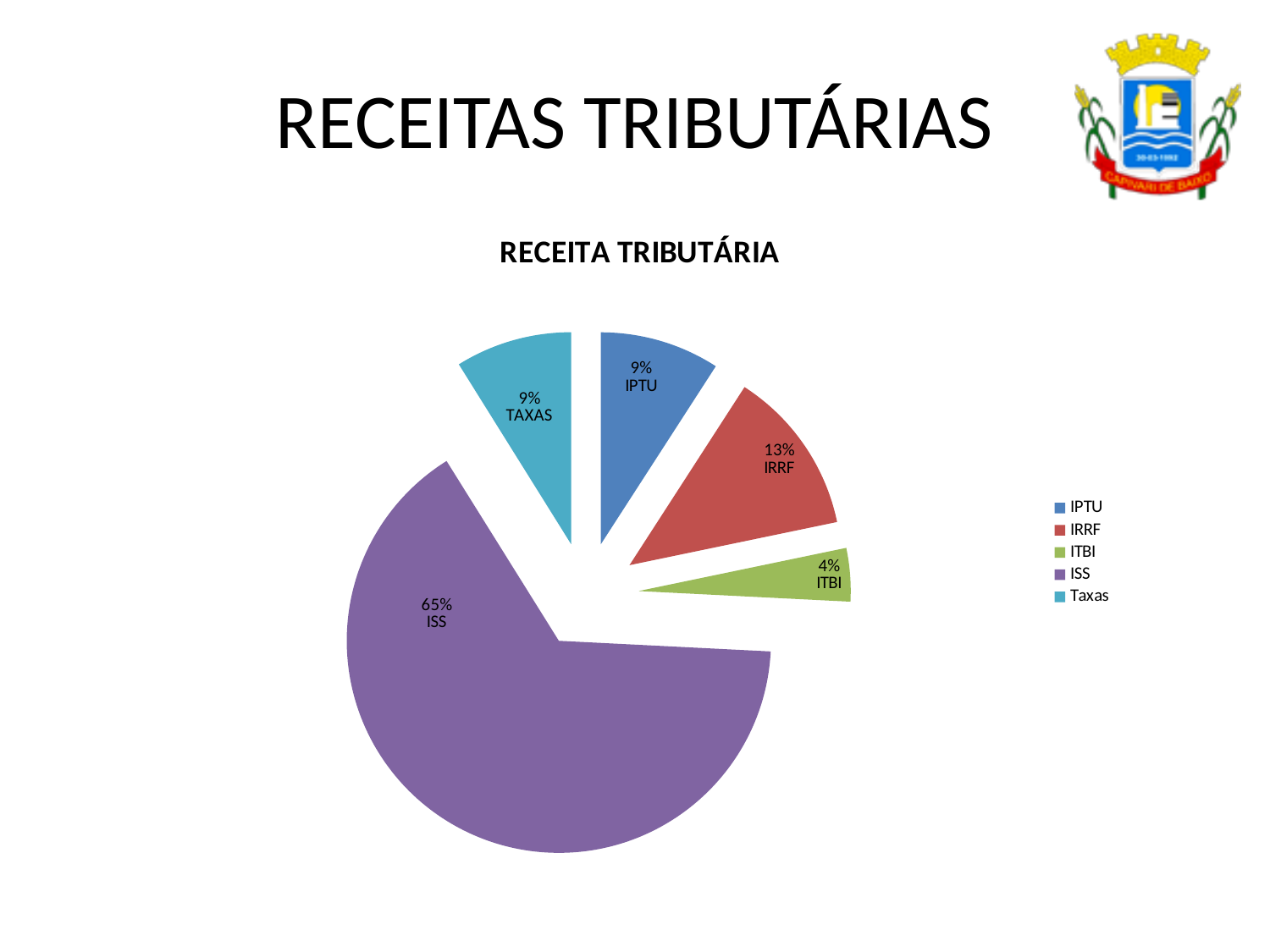
What share of the pie does ISS represent? 65% What share of the pie does ITBI represent? 4% How many slices does the pie chart have? 5 Which category has the largest slice of the pie? ISS Which is larger, the share for IRRF or the share for ITBI? IRRF What share of the pie does IPTU represent? 9% What is the difference in percentage points between the ISS share and the IRRF share? 52 What colour is the ISS slice? Purple Which category has the smallest slice of the pie? ITBI What is the title of the chart? RECEITA TRIBUTÁRIA What kind of chart is shown on the slide? Pie chart